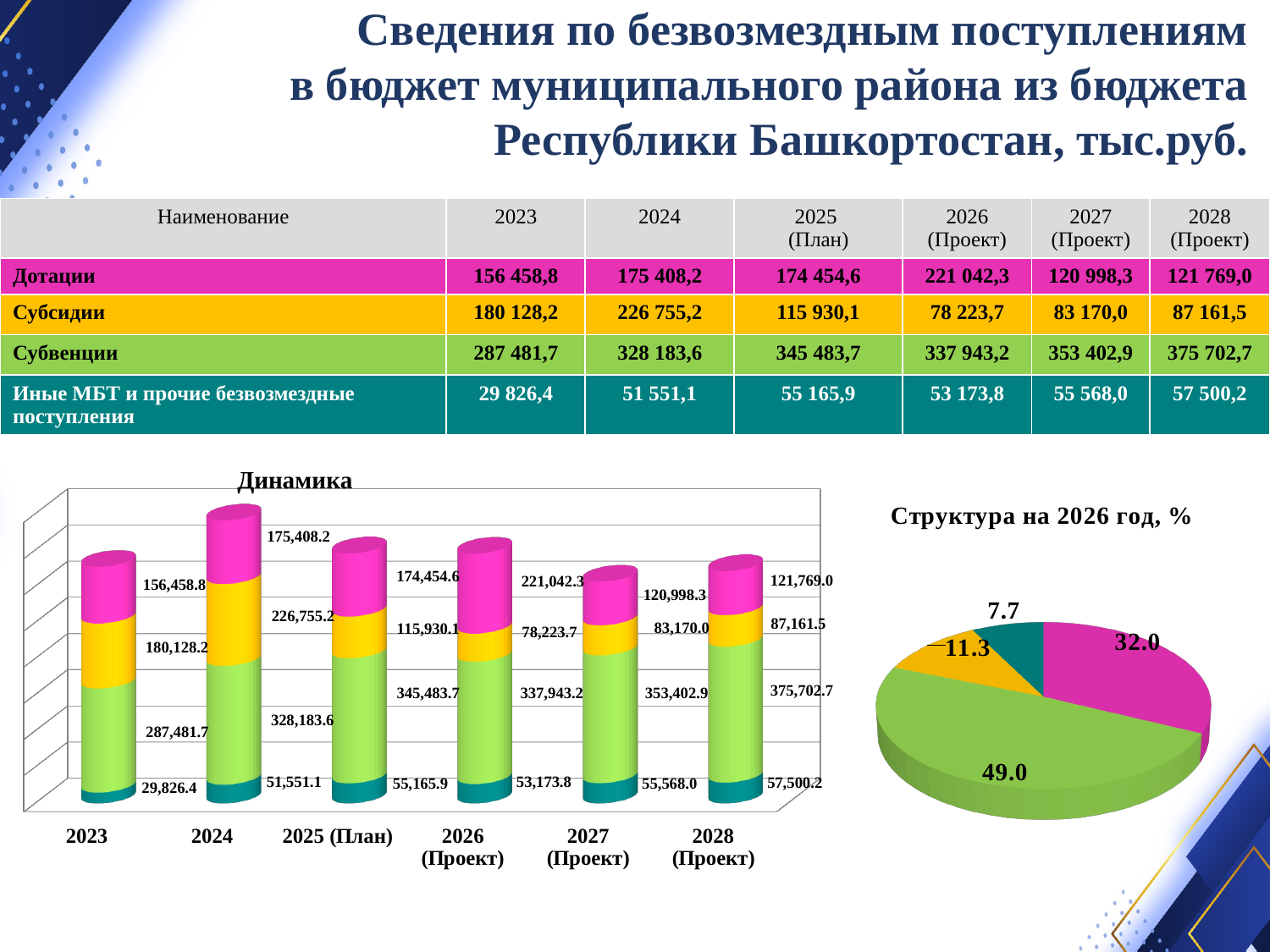
In the "Динамика" chart, what is the value of the top (pink) segment for 2024? 175,408.2 In the "Структура на 2026 год, %" chart, what is the value of the largest slice? 49.0 In the "Динамика" chart, what is the total of the stacked bar for 2023? 653,895.1 What kind of chart is the "Структура на 2026 год, %" chart? pie chart In the "Структура на 2026 год, %" chart, what is the value of the smallest slice? 7.7 In the "Динамика" chart, what is the value of the green segment for 2028 (Проект)? 375,702.7 In the "Динамика" chart, how many year categories are shown on the x axis? 6 What kind of chart is the "Динамика" chart? bar chart In the "Динамика" chart, which year has the larger green segment, 2023 or 2028 (Проект)? 2028 (Проект) In the "Структура на 2026 год, %" chart, what is the difference between the largest slice and the pink slice? 17.0 In the "Динамика" chart, what is the value of the bottom (teal) segment for 2023? 29,826.4 In the "Структура на 2026 год, %" chart, how many slices does the pie have? 4